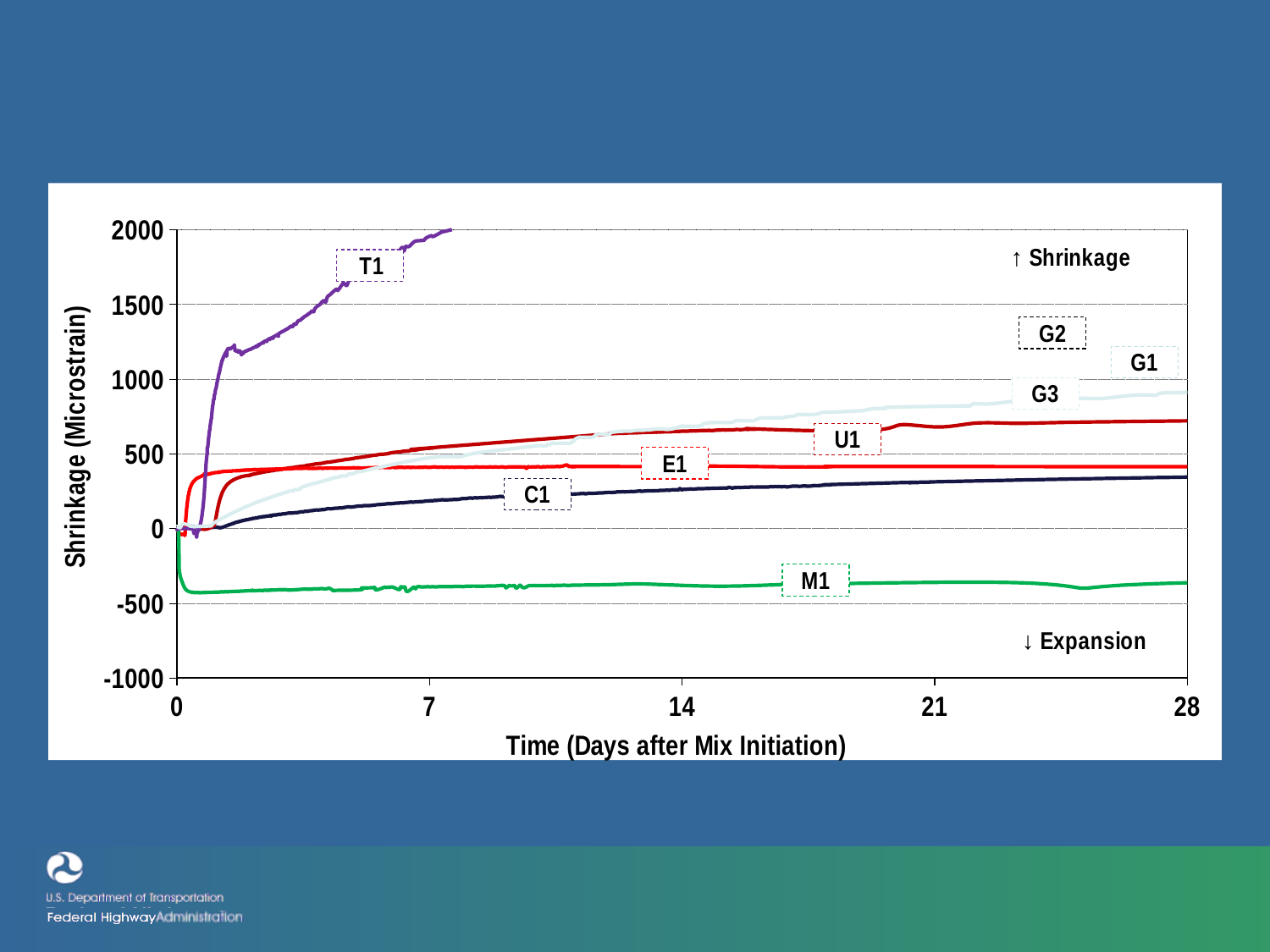
What kind of chart is shown on the slide? line chart Which series reaches the highest shrinkage value on the chart? T1 Is the value for C1 at day 28 greater or less than 500? less Is the value for U1 at day 28 greater or less than 500? greater Which series has the lowest values on the chart? M1 Does the T1 series rise or fall as time increases? rise Is the value for M1 at day 28 greater or less than 0? less What is the title of the y axis? Shrinkage (Microstrain) How many labelled series are plotted on the chart? 8 At day 28, which series has the larger value, U1 or C1? U1 What is the title of the x axis? Time (Days after Mix Initiation)